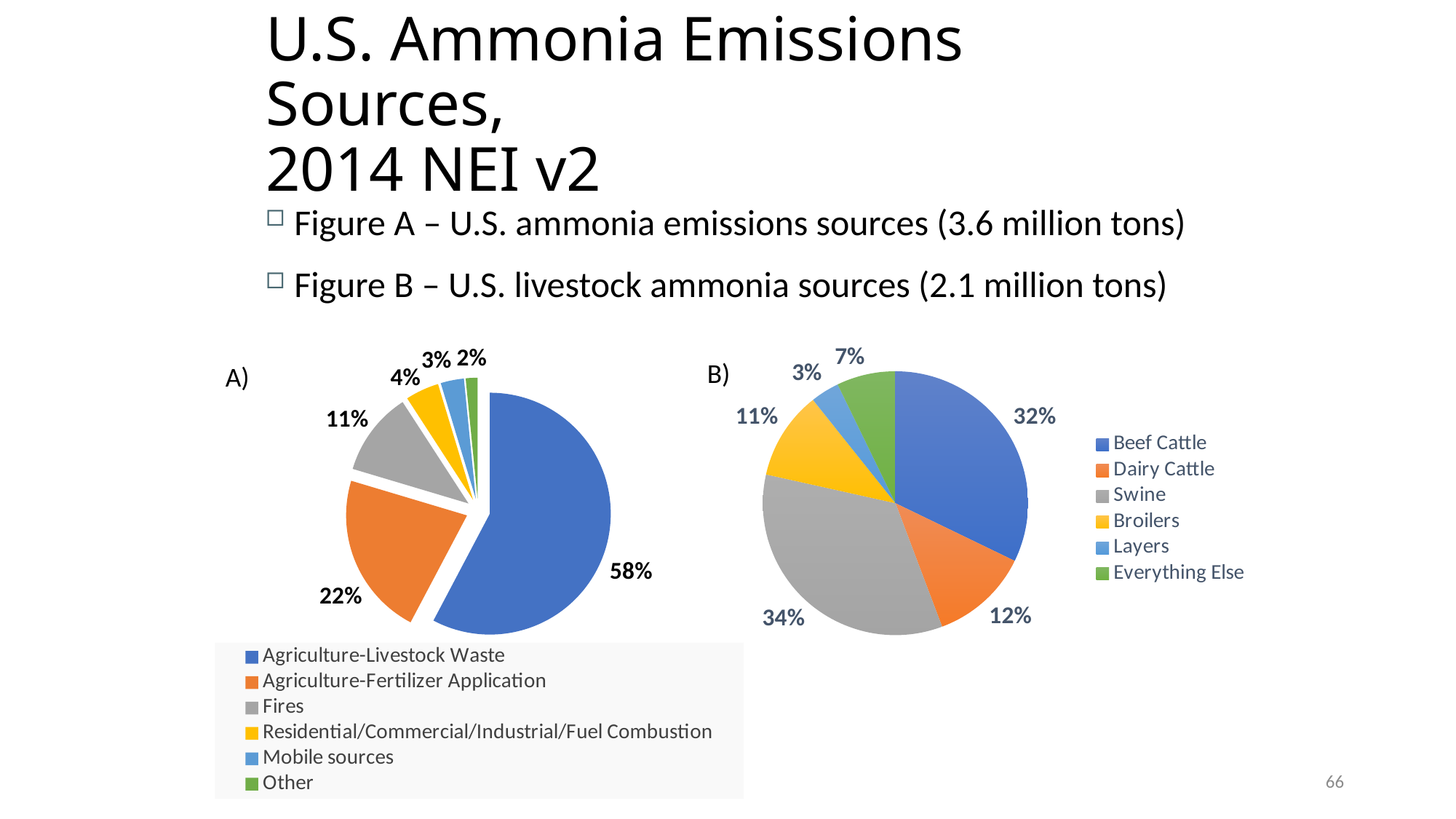
In Figure A (the left pie chart), what share is attributed to Fires? 11% In Figure B (the right pie chart), what share comes from Dairy Cattle? 12% In Figure B (the right pie chart), which colour represents Beef Cattle? Blue In Figure B (the right pie chart), what share of livestock ammonia comes from Swine? 34% In Figure A (the left pie chart), how many categories does the legend list? 6 In Figure A (the left pie chart), which source has the smallest share? Other In Figure A (the left pie chart), what is the difference between the Agriculture-Livestock Waste share and the Agriculture-Fertilizer Application share? 36 percentage points In Figure B (the right pie chart), which is larger, the Broilers share or the Everything Else share? Broilers What type of chart is used for Figure A and Figure B? Pie chart In Figure A (the left pie chart), what share of U.S. ammonia emissions comes from Agriculture-Livestock Waste? 58% In Figure B (the right pie chart), what is the difference between the Beef Cattle share and the Layers share? 29 percentage points In Figure B (the right pie chart), which livestock source has the largest share? Swine